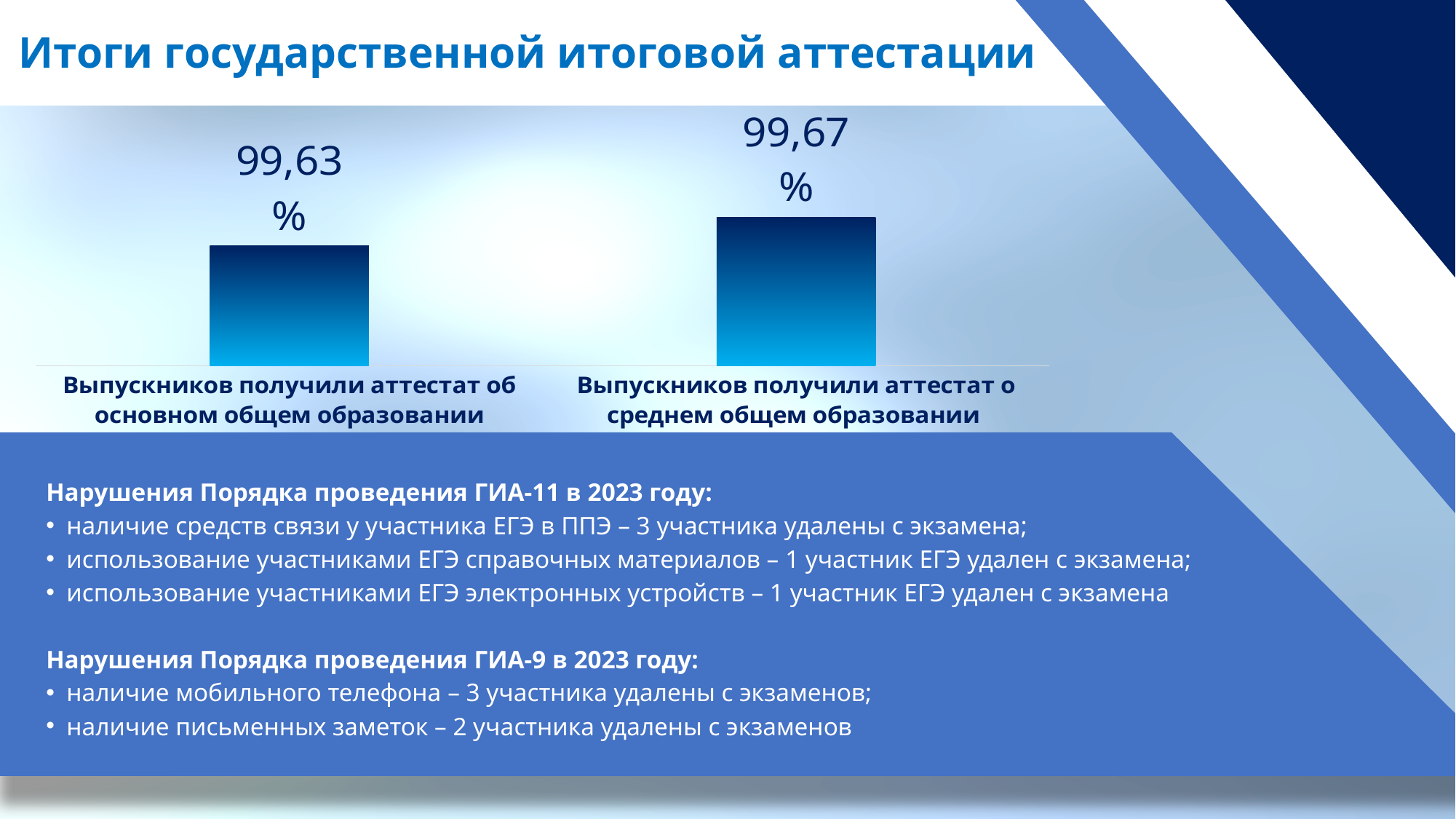
Which category has the higher value on the chart? Выпускников получили аттестат о среднем общем образовании Do the values rise or fall from the left bar to the right bar? rise What is the difference in percentage points between the two bars on the chart? 0,04 What percentage of graduates received a certificate of secondary general education (аттестат о среднем общем образовании)? 99,67% What colour are the bars on the chart? blue What is the title of the slide containing the chart? Итоги государственной итоговой аттестации What type of chart is shown on the slide? bar chart What percentage of graduates received a certificate of basic general education (аттестат об основном общем образовании)? 99,63% Is the value for basic general education certificates larger or smaller than the value for secondary general education certificates? smaller How many bars are shown on the chart? 2 Which category has the lower value on the chart? Выпускников получили аттестат об основном общем образовании